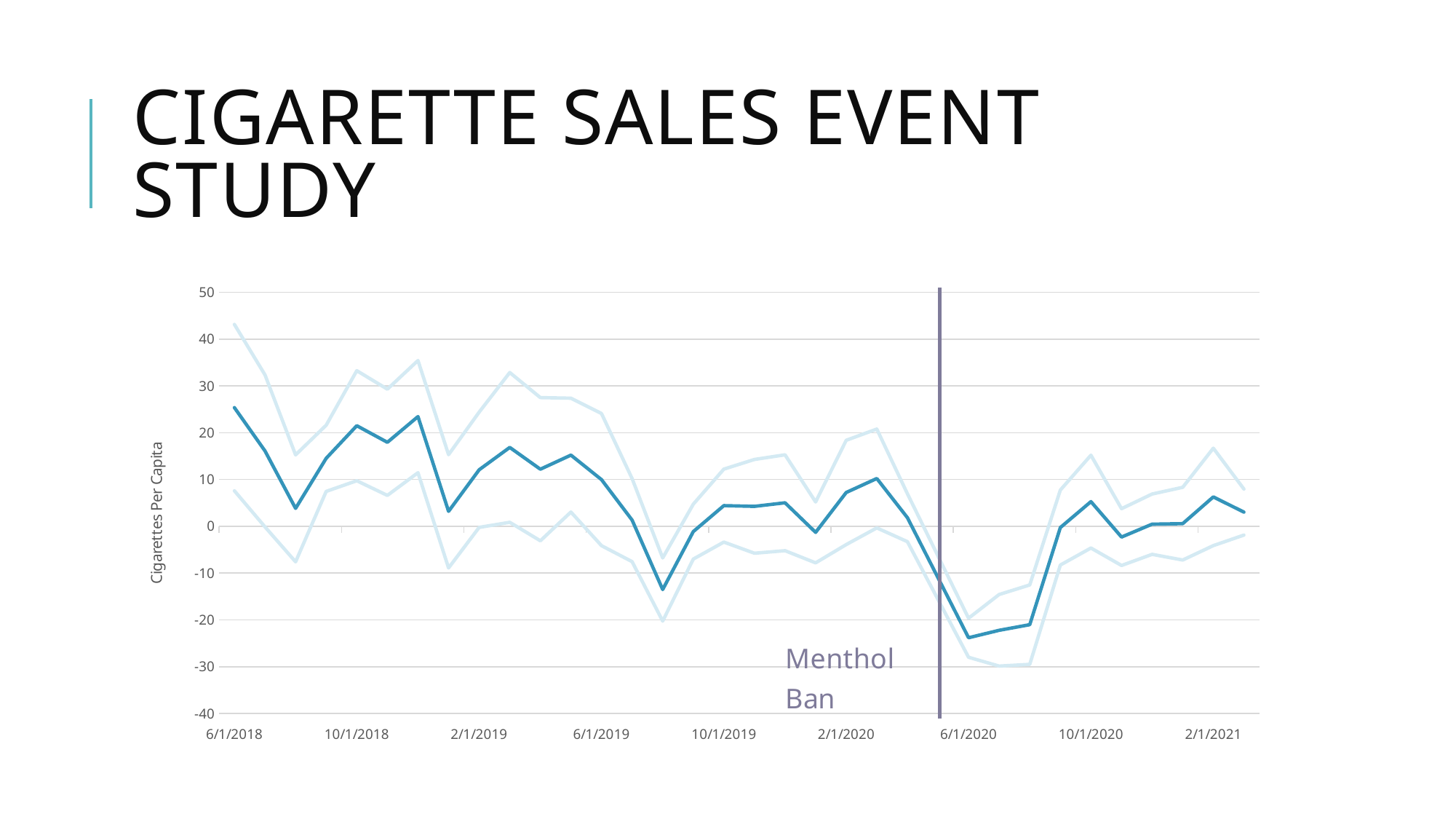
Is the value of the dark blue line at 6/1/2020 greater or less than -10? less Near which x-axis date does the dark blue line reach its lowest value? 6/1/2020 Is the value of the lower light blue line at 6/1/2018 greater or less than 10? less What kind of chart is shown on the slide? line chart Is the value of the upper light blue line at 6/1/2018 greater or less than 40? greater What event does the vertical line on the chart mark? Menthol Ban Does the dark blue line rise or fall between 6/1/2018 and 6/1/2020? fall How many lines are plotted on the chart? 3 What is the label on the vertical axis of the chart? Cigarettes Per Capita